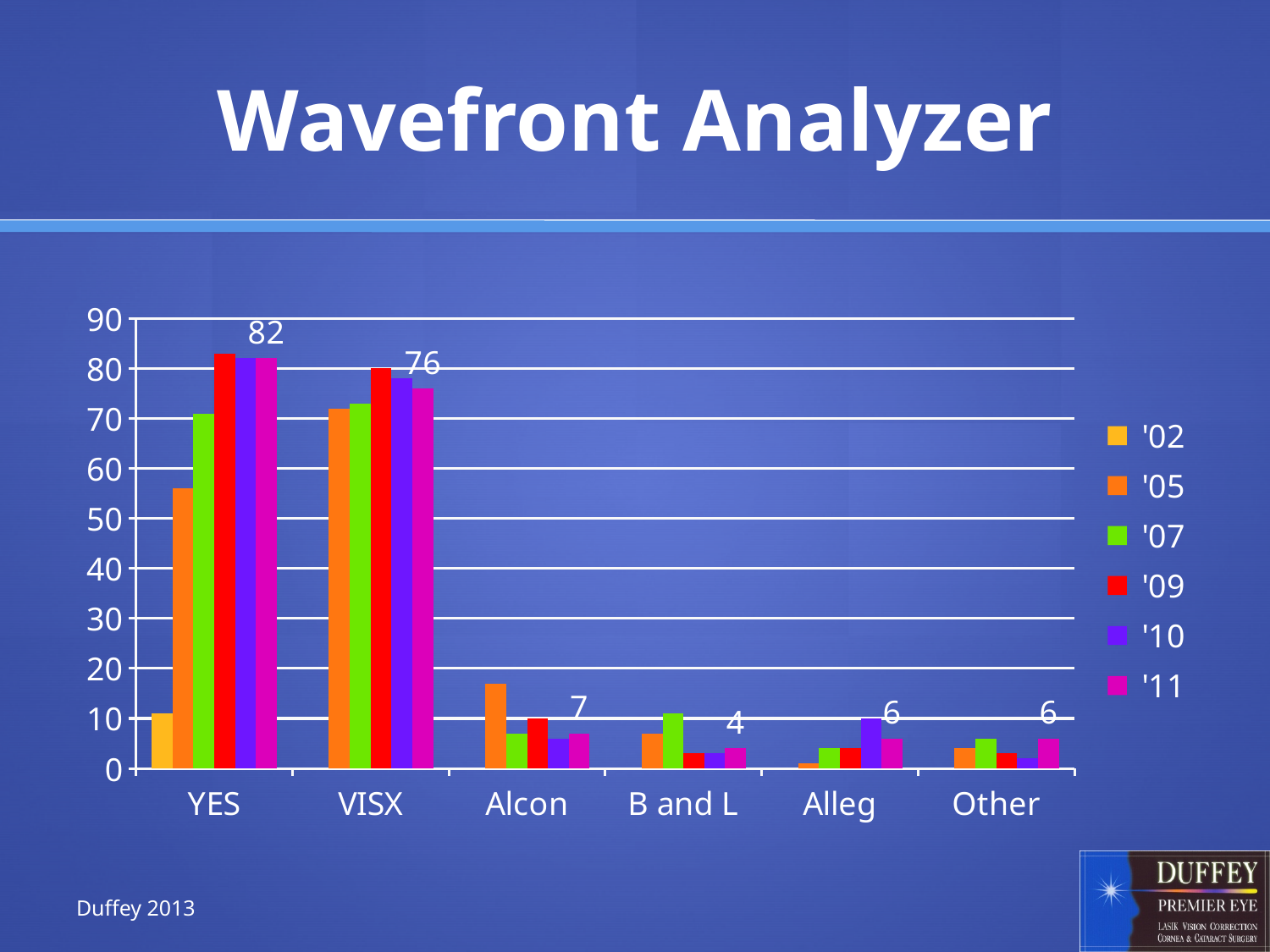
Is the '02 value for YES greater or less than 20? less What kind of chart is shown on the slide? bar chart Which category has the lowest '11 value? B and L Which category has the highest '11 value? YES How many categories are shown on the x axis? 6 What is the '11 value for YES? 82 What is the difference between the '11 values for YES and VISX? 6 Is the '05 value for YES greater or less than 50? greater What is the '11 value for Alcon? 7 What is the '11 value for B and L? 4 How many series does the legend list? 6 What is the '11 value for VISX? 76